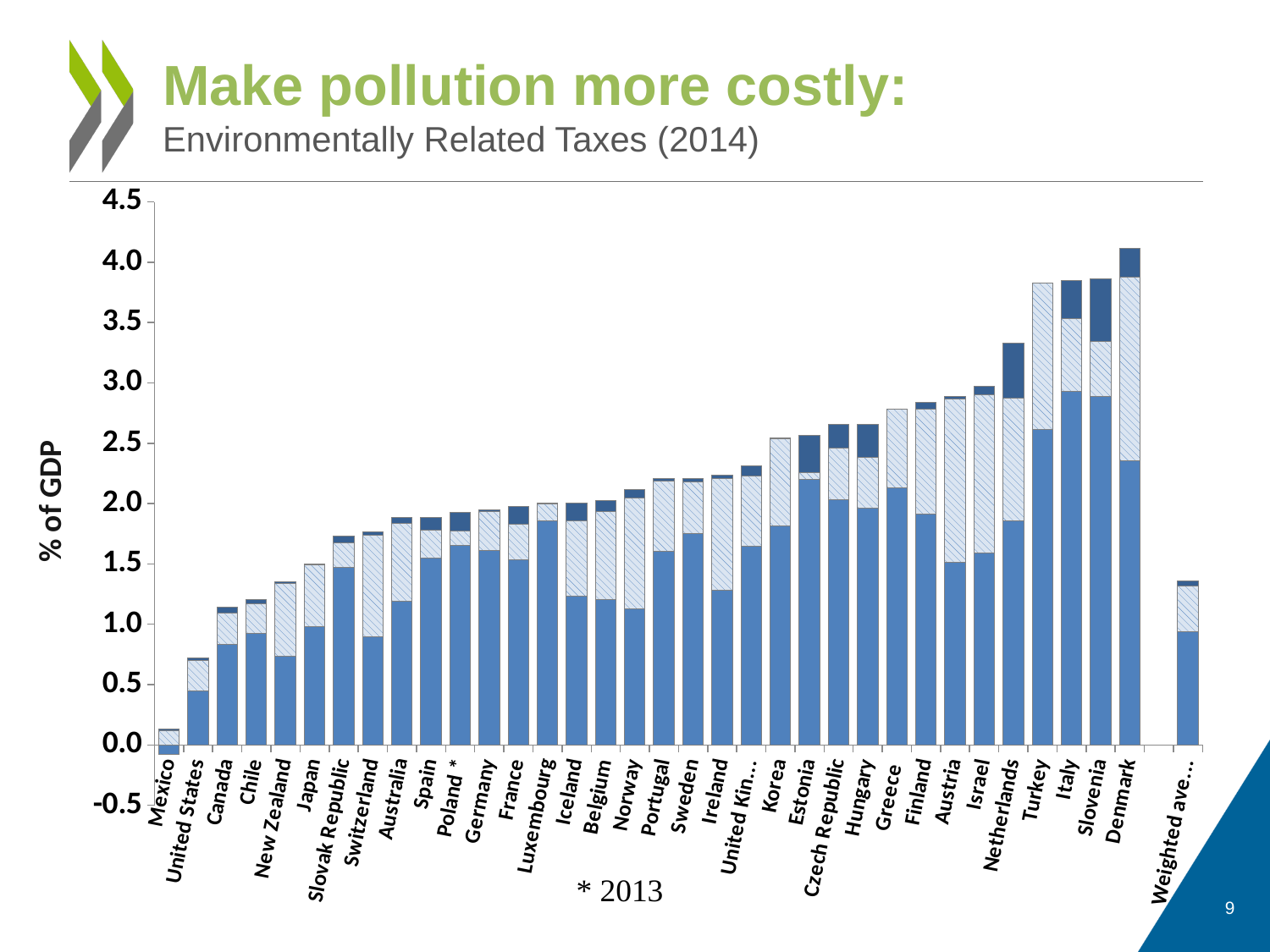
Is the total value for Denmark greater or less than 4.0? greater Is the total value for Turkey greater or less than 3.5? greater Do the country totals generally rise or fall from left to right across the x axis (excluding the weighted average)? rise What is the label on the vertical axis? % of GDP Which has a larger total value, Denmark or Turkey? Denmark What kind of chart is shown on the slide? bar chart Is the total value for Netherlands greater or less than 3.0? greater Which has a larger total value, Netherlands or Israel? Netherlands Which country has the highest total environmentally related taxes as a % of GDP? Denmark Which country has the lowest total environmentally related taxes as a % of GDP? Mexico